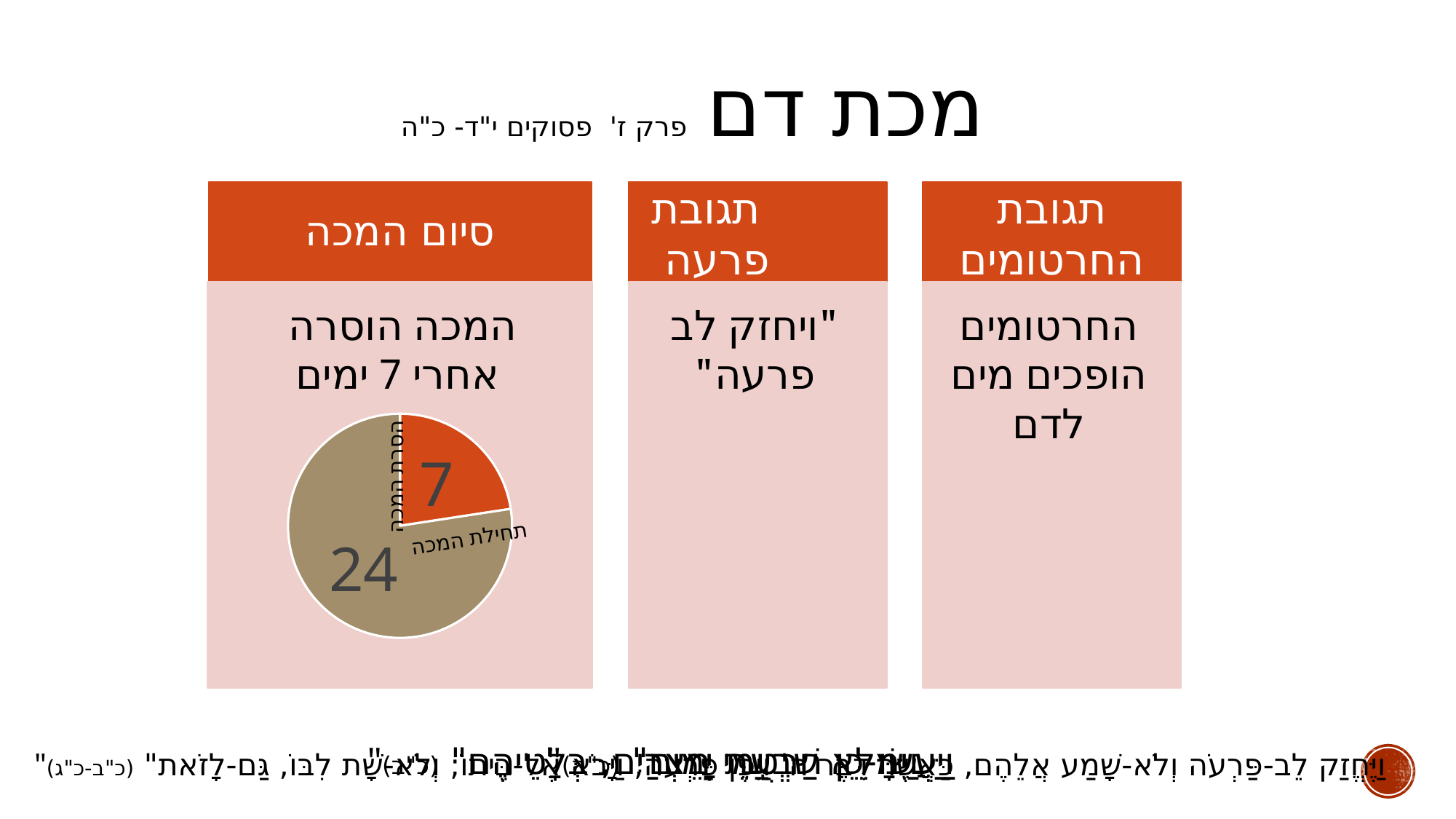
Which slice of the pie chart has the smallest value? 7 What fraction of the pie does the slice labelled 7 represent? 7 out of 31 What value is printed on the brown slice of the pie chart? 24 Under which column heading does the pie chart appear? סיום המכה Which slice is larger, the orange slice or the brown slice? the brown slice What is the difference between the two values shown in the pie chart? 17 What colour is the slice labelled 7 in the pie chart? orange How many slices does the pie chart have? 2 What value is printed on the orange slice of the pie chart? 7 Which slice of the pie chart has the largest value? 24 What kind of chart is shown on the slide? pie chart What is the total of the two values shown in the pie chart? 31